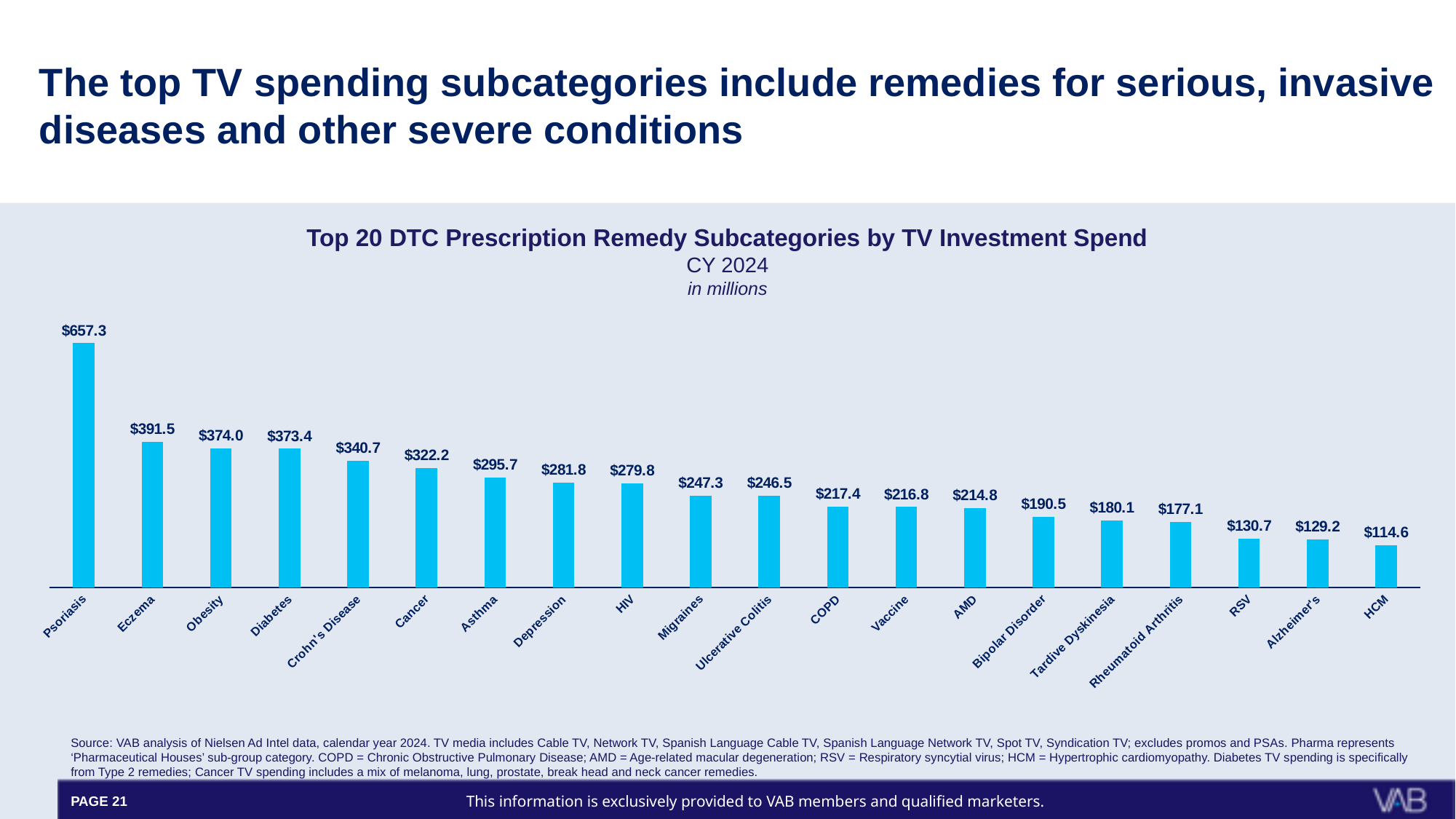
What is the TV investment spend for Crohn's Disease? $340.7 What is the difference in TV investment spend between Psoriasis and Eczema? $265.8 What is the difference in TV investment spend between Cancer and Asthma? $26.5 Which subcategory has the lowest TV investment spend? HCM Which has a higher TV investment spend, RSV or Rheumatoid Arthritis? Rheumatoid Arthritis How many subcategories are shown in the chart? 20 What is the TV investment spend for Psoriasis? $657.3 Which has a higher TV investment spend, Migraines or COPD? Migraines What is the TV investment spend for Bipolar Disorder? $190.5 Which subcategory has the highest TV investment spend? Psoriasis What type of chart is shown on the slide? Bar chart What is the title of the chart? Top 20 DTC Prescription Remedy Subcategories by TV Investment Spend